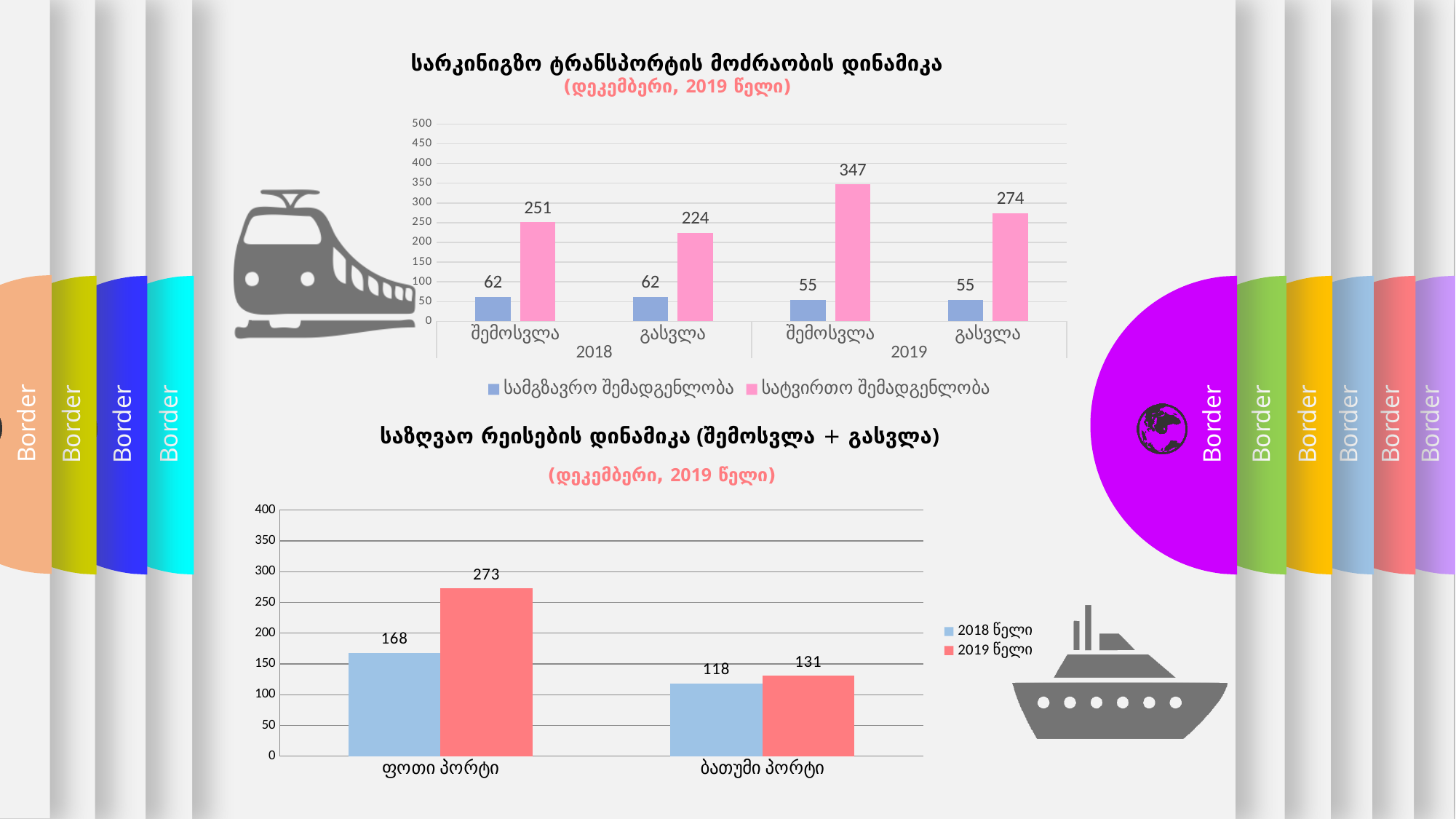
In the bottom chart, which port has the larger 2019 წელი value, ფოთი პორტი or ბათუმი პორტი? ფოთი პორტი In the bottom chart, what is the difference between the 2019 წელი and 2018 წელი values for ფოთი პორტი? 105 In the bottom chart (საზღვაო რეისების დინამიკა), what is the value for ფოთი პორტი in 2019 წელი? 273 In the top chart, what is the difference between the სატვირთო შემადგენლობა values for შემოსვლა in 2019 and შემოსვლა in 2018? 96 In the top chart, which category has the highest სატვირთო შემადგენლობა value? შემოსვლა 2019 In the bottom chart, how many categories are shown on the x axis? 2 In the top chart (სარკინიგზო ტრანსპორტის მოძრაობის დინამიკა), what is the value of სატვირთო შემადგენლობა for შემოსვლა in 2019? 347 In the top chart, is the სატვირთო შემადგენლობა value for გასვლა in 2018 greater or less than 200? greater In the bottom chart, what is the value for ბათუმი პორტი in 2018 წელი? 118 In the top chart, what is the value of სამგზავრო შემადგენლობა for გასვლა in 2018? 62 In the top chart, how many series does the legend list? 2 What type of chart is the bottom chart? bar chart